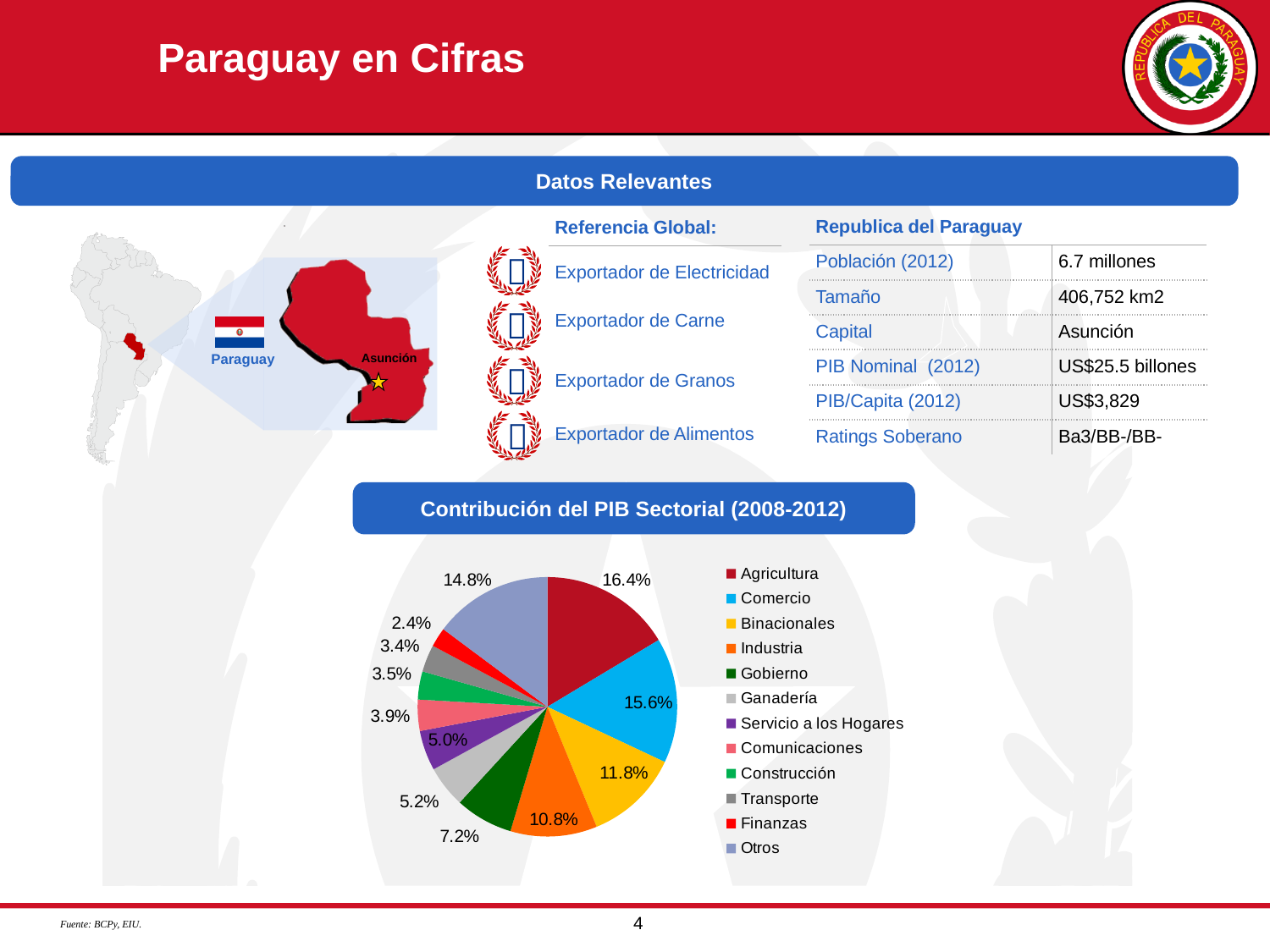
How many sectors are listed in the legend of the pie chart? 12 Which sector has the largest slice in the pie chart? Agricultura What share of the pie does Agricultura represent in the 'Contribución del PIB Sectorial (2008-2012)' chart? 16.4% What is the difference between the Agricultura and Comercio shares in the pie chart? 0.8% What is the title of the chart on the slide? Contribución del PIB Sectorial (2008-2012) What percentage is labelled for Binacionales in the pie chart? 11.8% What type of chart is used to show the 'Contribución del PIB Sectorial (2008-2012)'? Pie chart Which sector has the smallest slice in the pie chart? Finanzas What is the value shown for Comercio in the pie chart? 15.6% What is the combined share of Ganadería and Servicio a los Hogares in the pie chart? 10.2% What is the value for Otros in the pie chart? 14.8% Which is larger in the pie chart, Industria or Gobierno? Industria